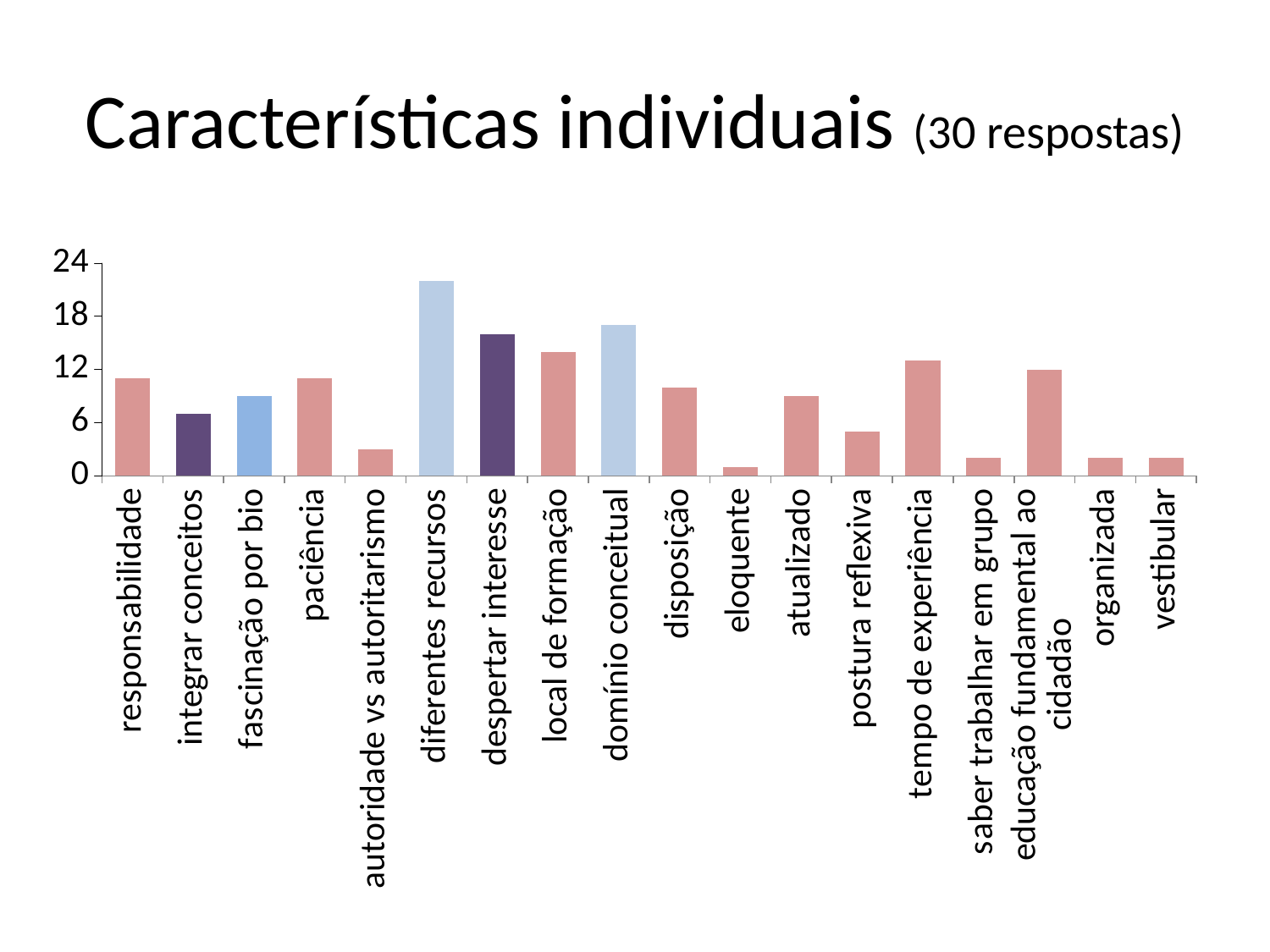
Which is larger, the value for diferentes recursos or the value for domínio conceitual? diferentes recursos Which category has the highest bar? diferentes recursos Which is larger, the value for integrar conceitos or the value for local de formação? local de formação What is the title of the slide containing the chart? Características individuais (30 respostas) Is the value for autoridade vs autoritarismo greater or less than 6? less Is the value for postura reflexiva greater or less than 6? less Is the value for diferentes recursos greater or less than 18? greater Which category has the lowest bar? eloquente How many categories are plotted on the x axis? 18 What kind of chart is shown on the slide? bar chart